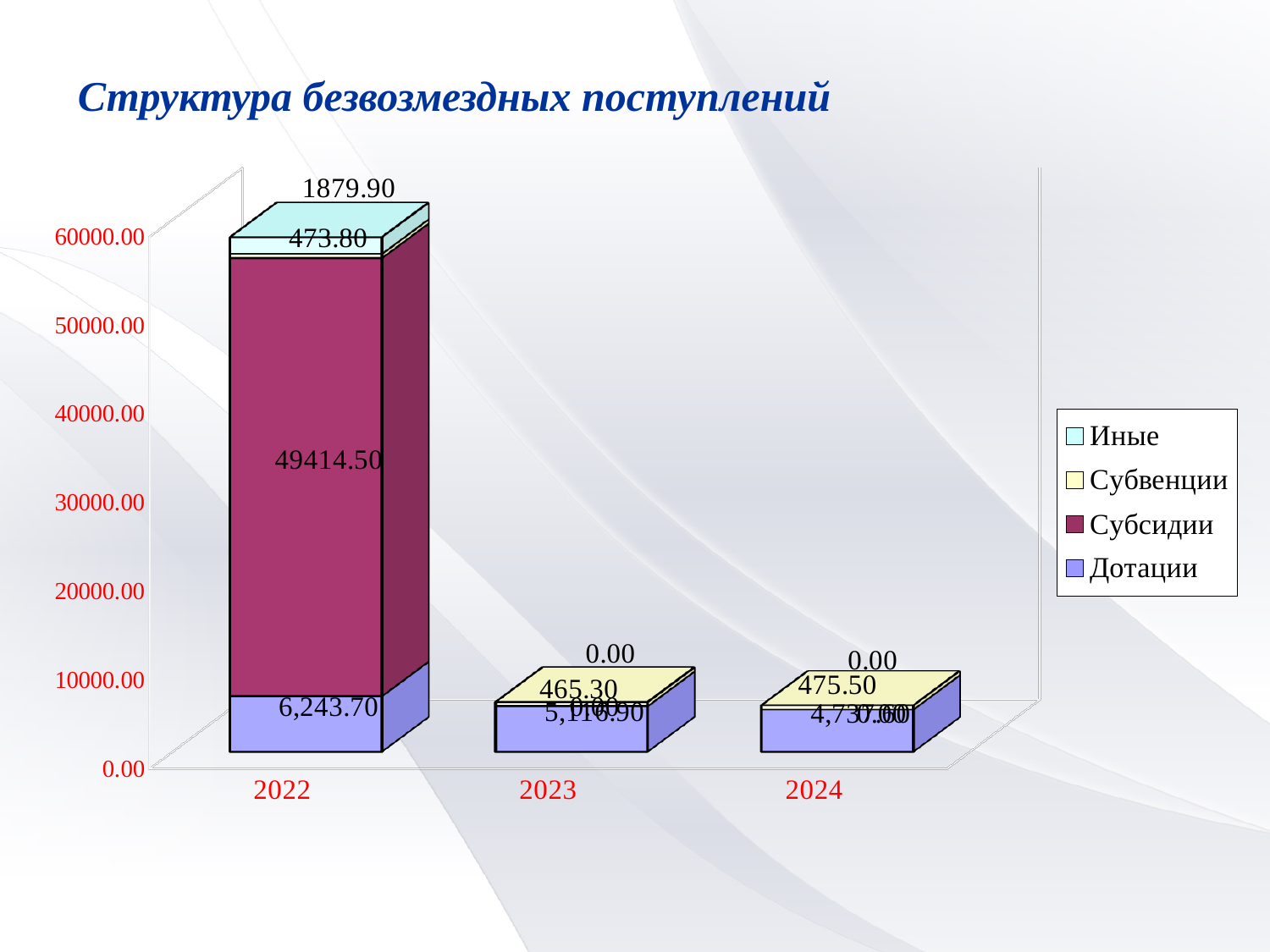
What is the value for Иные in 2024? 0.00 What is the value for Субвенции in 2024? 475.50 What is the value for Субсидии in 2022? 49414.50 What is the value for Иные in 2022? 1879.90 What is the total of the stacked bar for 2022? 58011.90 What is the value for Субвенции in 2023? 465.30 Which is larger, Субвенции in 2022 or Субвенции in 2024? Субвенции in 2024 How many series does the legend list? 4 Which year has the tallest stacked bar? 2022 What is the value for Дотации in 2022? 6,243.70 What is the difference between the Субвенции values for 2024 and 2023? 10.20 What kind of chart is shown on the slide? Stacked bar chart